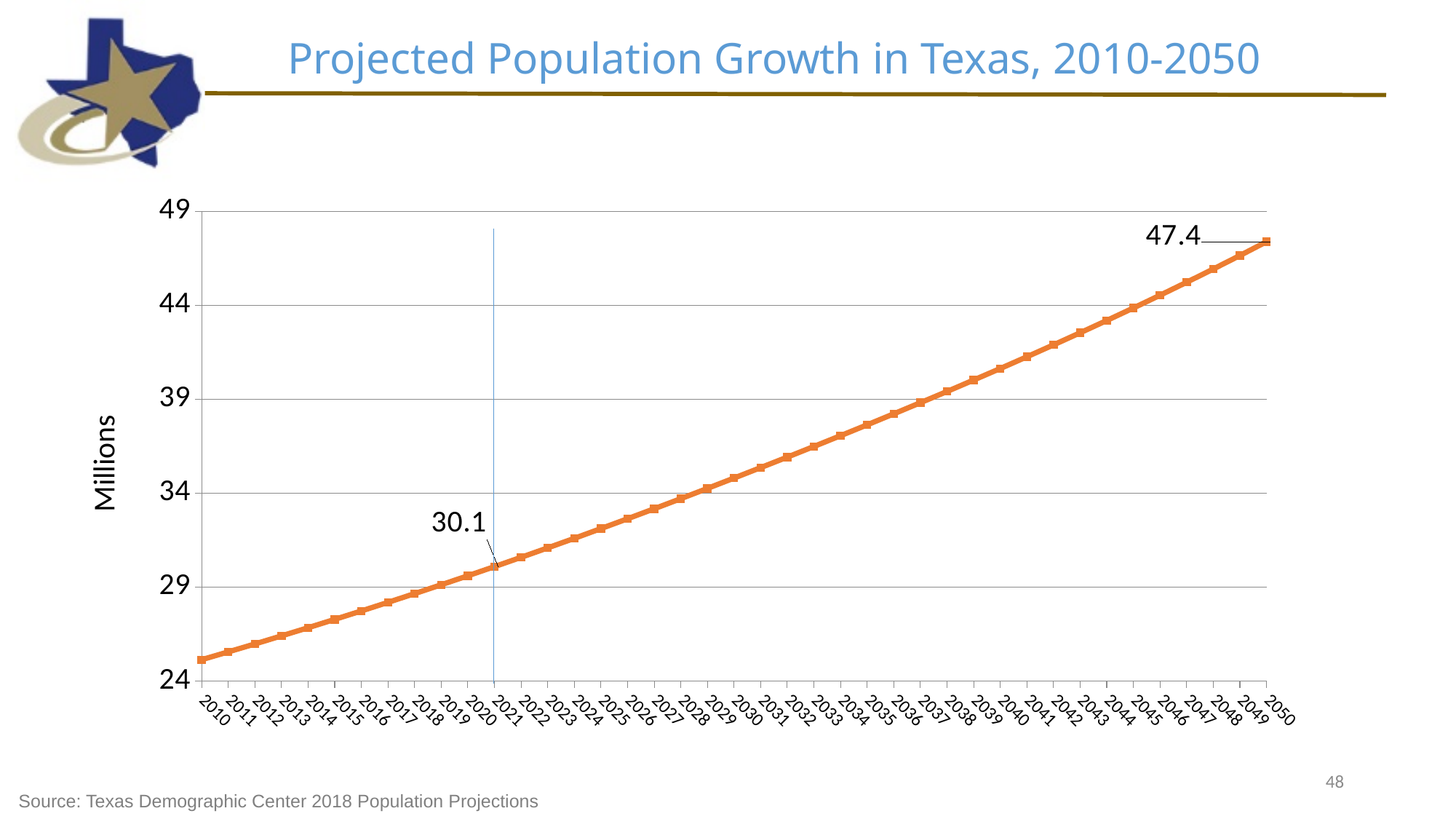
Is the value for 2040 greater or less than 39? greater What kind of chart is shown on the slide? line chart Is the value for 2035 greater or less than 39? less Is the value for 2010 greater or less than 29? less Which year has the highest projected population on the chart? 2050 What is the projected population value labelled for 2021? 30.1 Do the values rise or fall from 2010 to 2050? rise What is the projected population value labelled for 2050? 47.4 What is the difference between the labelled values for 2050 and 2021? 17.3 What is the label on the vertical axis of the chart? Millions Which is larger, the value for 2030 or the value for 2020? 2030 Which year has the lowest projected population on the chart? 2010